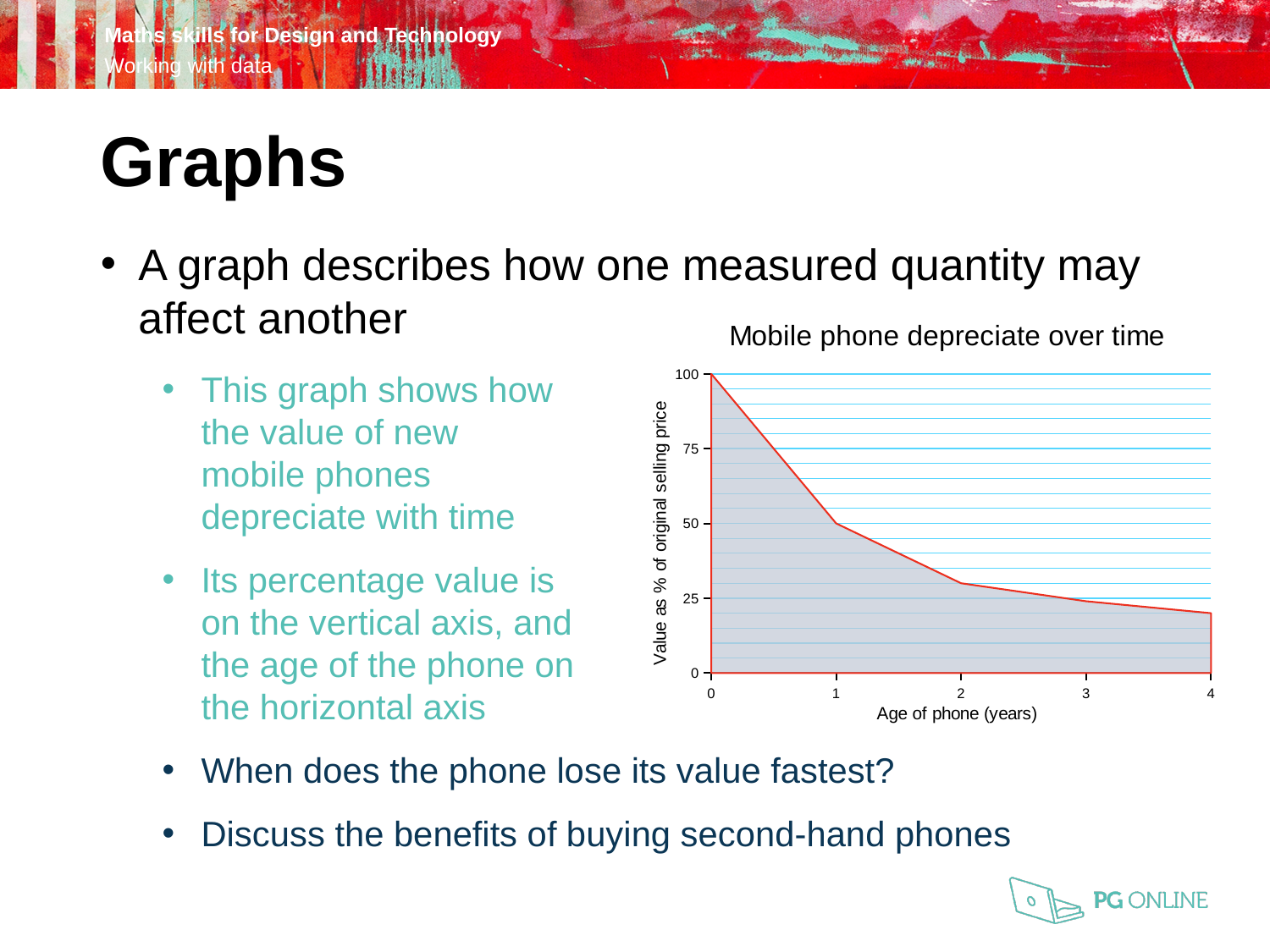
What is the difference in value between a phone aged 0 years and a phone aged 1 year? 50 Is the value for a phone aged 2 years greater or less than 50? less Is the value for a phone aged 2 years greater or less than 25? greater What is the value as % of original selling price when the phone is 0 years old? 100 Which has the larger value: a phone aged 1 year or a phone aged 3 years? 1 year Is the value for a phone aged 4 years greater or less than 25? less What is the title of the chart? Mobile phone depreciate over time At which age of phone is the value as % of original selling price highest? 0 years Do the values rise or fall as the age of the phone increases? fall What kind of chart is shown on the slide? area chart What is the value as % of original selling price when the phone is 1 year old? 50 What is the label of the horizontal axis of the chart? Age of phone (years)